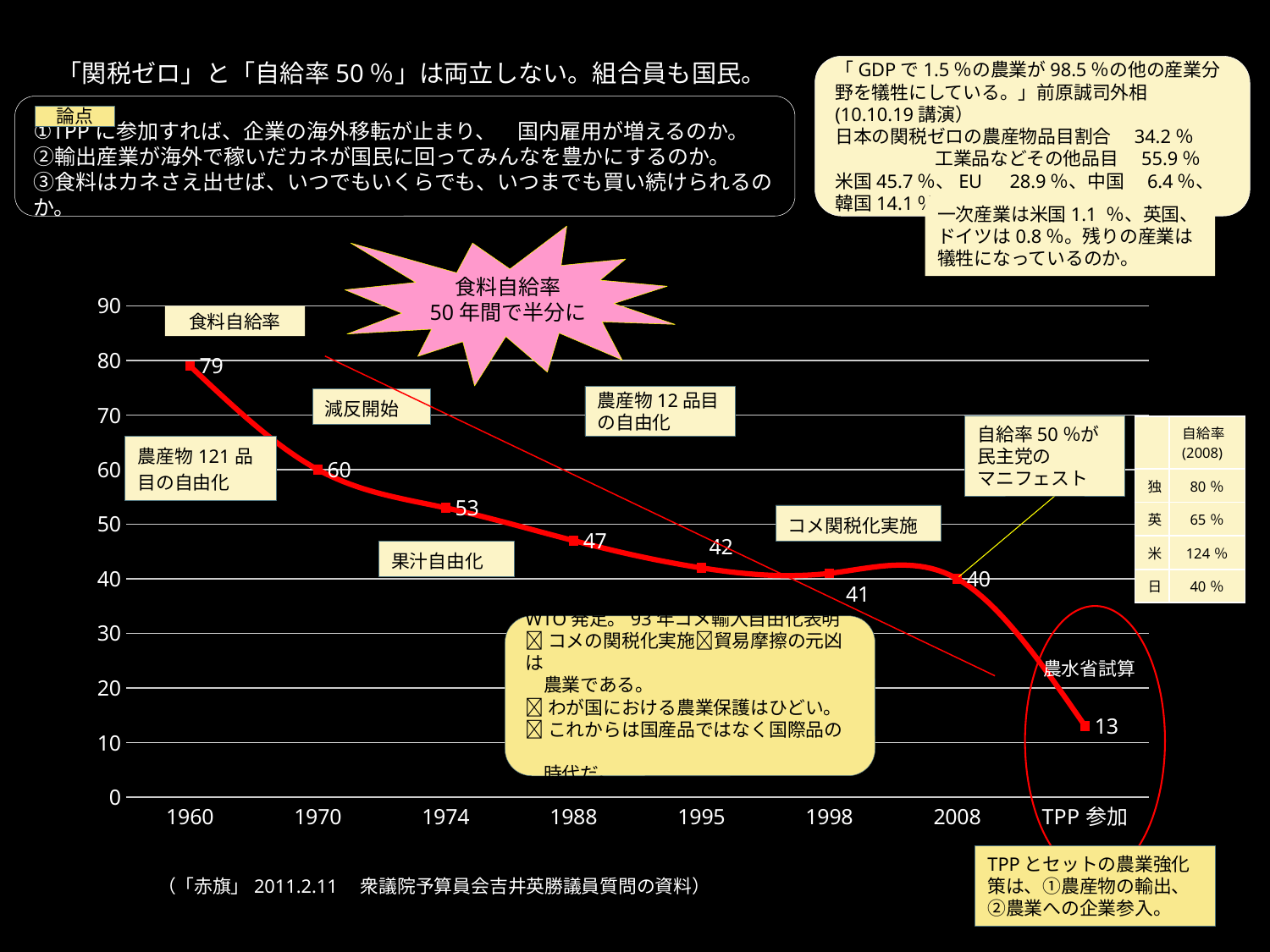
Which x-axis category has the lowest 食料自給率 value? TPP 参加 Which x-axis category has the highest 食料自給率 value? 1960 What kind of chart is shown on the slide? line chart Which is larger, the 食料自給率 value for 1974 or for 1995? 1974 What is the value of 食料自給率 for 1988? 47 What is the value of 食料自給率 for 2008? 40 What is the value of 食料自給率 for 1960? 79 Do the 食料自給率 values rise or fall along the x axis from 1960 to TPP 参加? fall What is the value of 食料自給率 for 1970? 60 How many x-axis categories are plotted on the chart? 8 What is the value of 食料自給率 for TPP 参加? 13 What is the difference between the 食料自給率 values for 1960 and 2008? 39